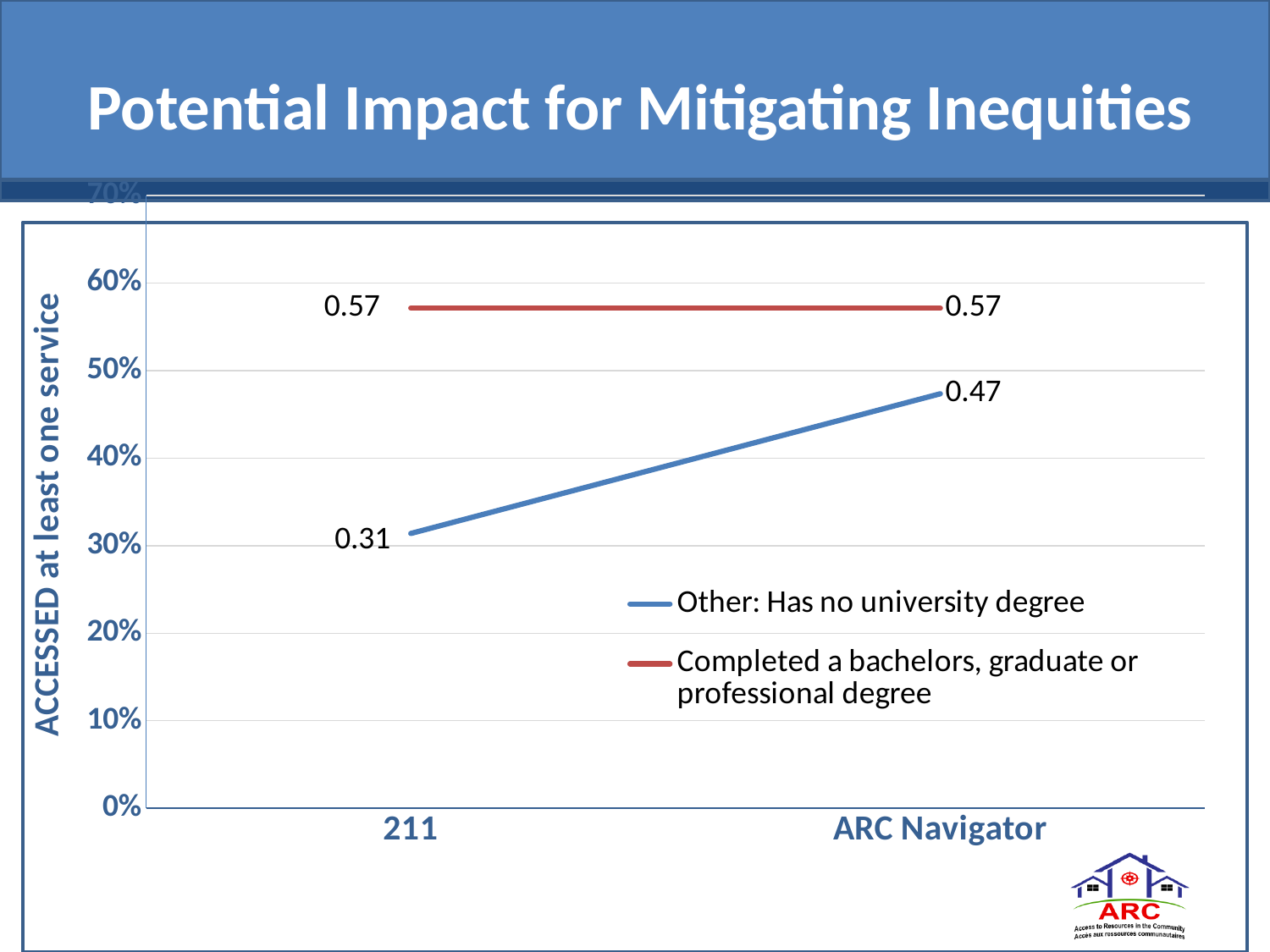
What is the value for "Completed a bachelors, graduate or professional degree" at ARC Navigator? 0.57 What is the difference between the two series at ARC Navigator? 0.10 How many series does the legend list? 2 What is the value for "Completed a bachelors, graduate or professional degree" at 211? 0.57 What is the value for "Other: Has no university degree" at 211? 0.31 Which series has the higher value at 211? Completed a bachelors, graduate or professional degree What kind of chart is shown on the slide? line chart What is the difference between the two series at 211? 0.26 Does the value for "Other: Has no university degree" rise or fall from 211 to ARC Navigator? rise What is the value for "Other: Has no university degree" at ARC Navigator? 0.47 What is the label of the y axis? ACCESSED at least one service How many categories are shown on the x axis? 2